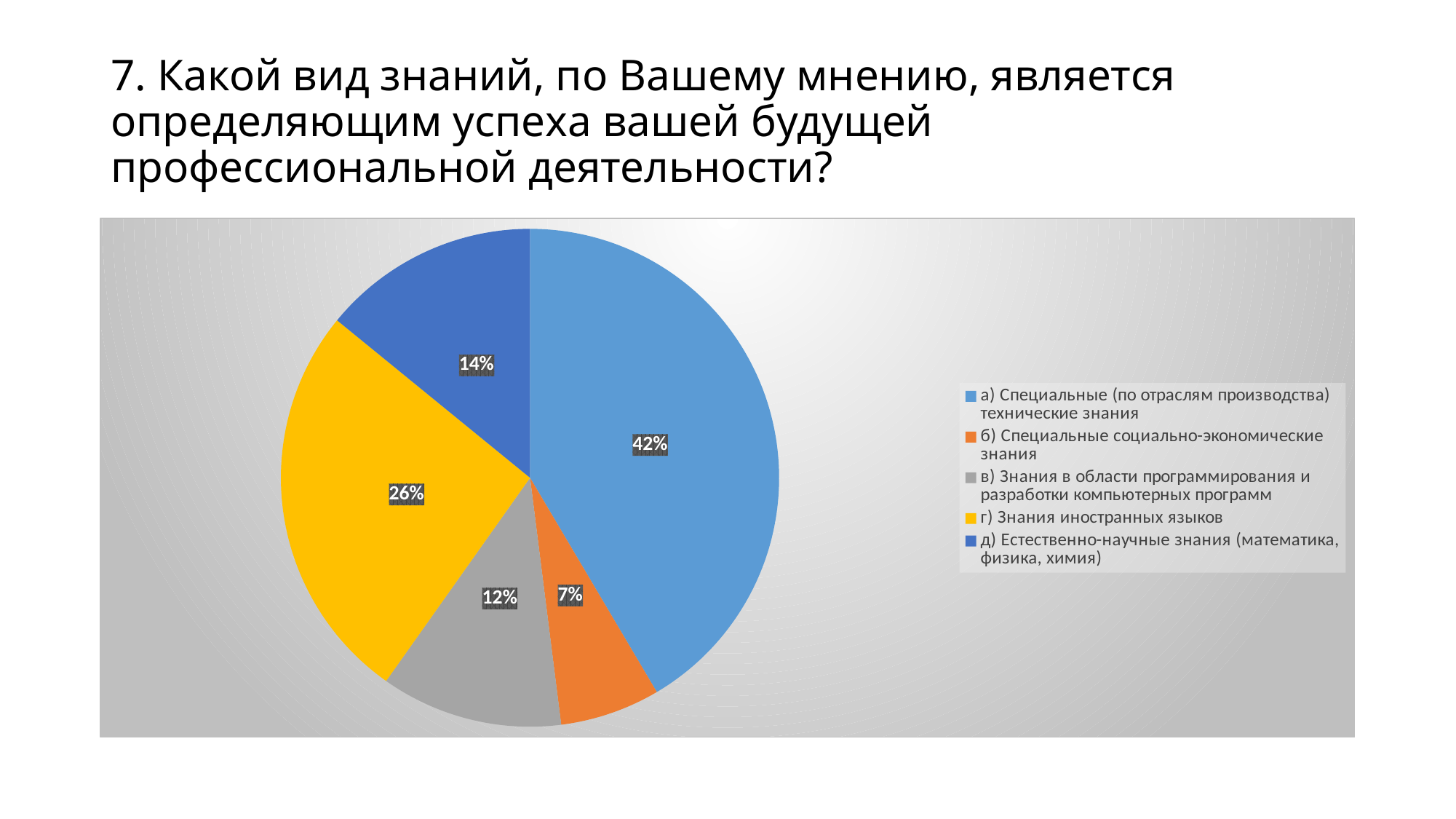
How many categories does the legend list? 5 Which slice is larger: 'д) Естественно-научные знания (математика, физика, химия)' or 'в) Знания в области программирования и разработки компьютерных программ'? д) Естественно-научные знания (математика, физика, химия) What share of the pie is labelled for 'д) Естественно-научные знания (математика, физика, химия)'? 14% What share of the pie is labelled for 'г) Знания иностранных языков'? 26% What share of the pie is labelled for 'б) Специальные социально-экономические знания'? 7% What type of chart is shown on the slide? pie chart Which category has the smallest slice of the pie? б) Специальные социально-экономические знания What share of the pie is labelled for 'а) Специальные (по отраслям производства) технические знания'? 42% What is the difference in percentage points between the slice for 'а) Специальные (по отраслям производства) технические знания' and the slice for 'г) Знания иностранных языков'? 16 What share of the pie is labelled for 'в) Знания в области программирования и разработки компьютерных программ'? 12% Which category has the largest slice of the pie? а) Специальные (по отраслям производства) технические знания What colour is the slice for 'г) Знания иностранных языков'? yellow